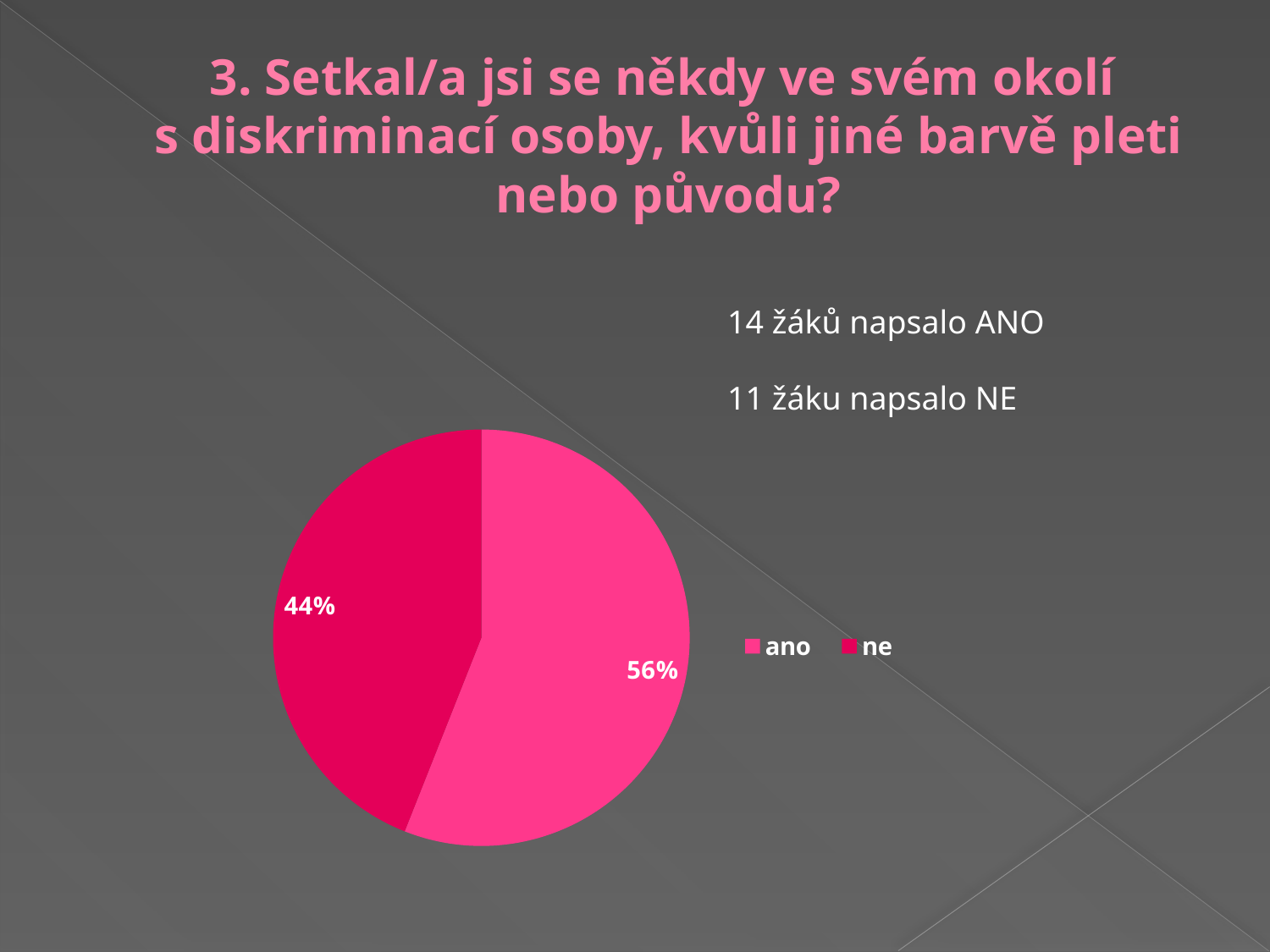
What share of the pie does "ne" take? 44% Which is larger, the "ano" slice or the "ne" slice? ano Which legend entry is shown in the darker pink colour? ne What kind of chart is shown on the slide? pie chart What share of the pie does "ano" take? 56% Which slice is the largest? ano Which slice is the smallest? ne How many slices does the pie chart have? 2 What are the two legend entries of the pie chart? ano, ne Is the share for "ano" greater or less than 50%? greater How many entries does the legend list? 2 What is the difference in percentage points between the "ano" and "ne" slices? 12 percentage points